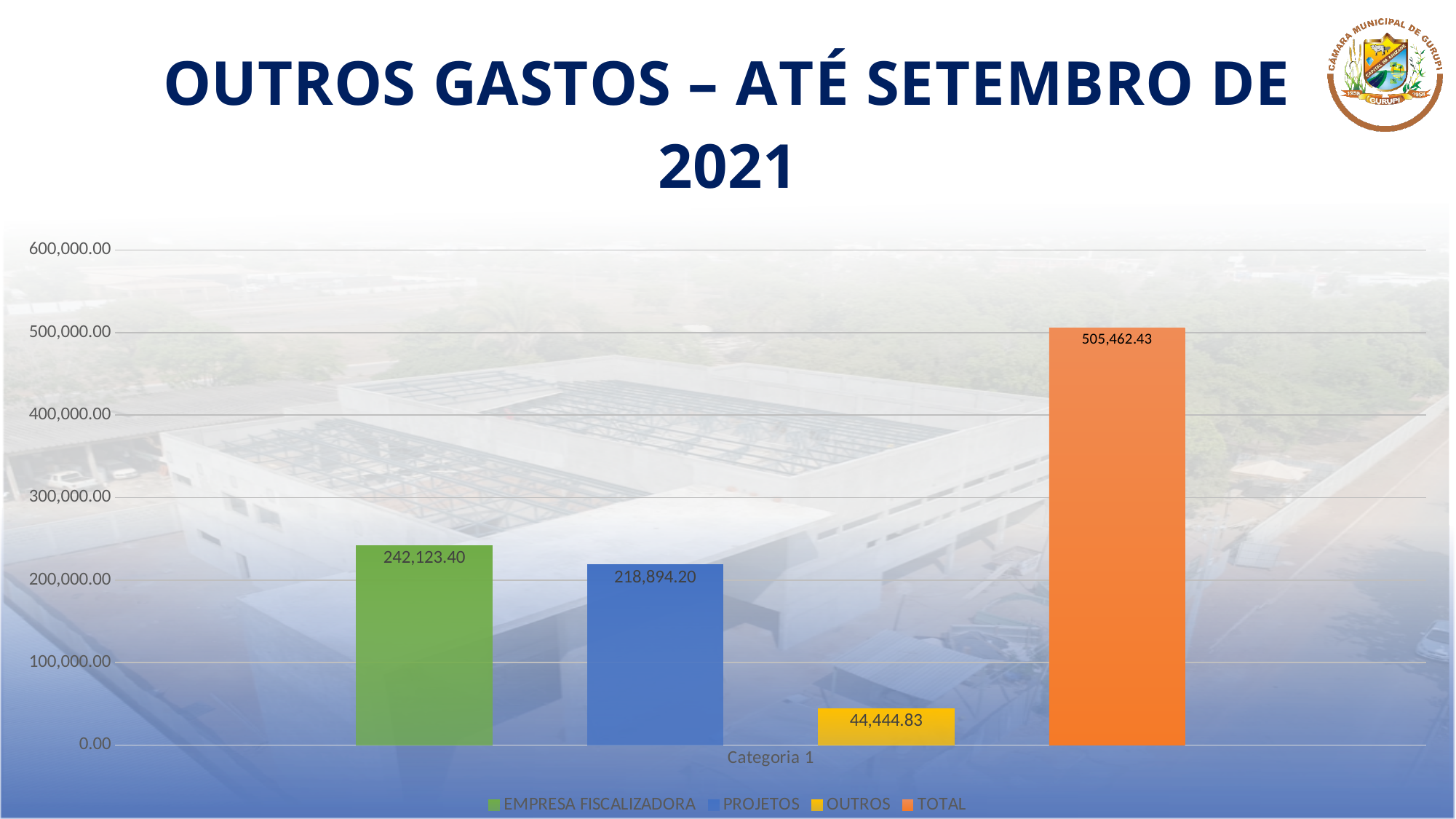
Is the value for TOTAL greater or less than 500,000.00? greater Which series has the highest value? TOTAL What kind of chart is shown on the slide? Bar chart Which is larger, EMPRESA FISCALIZADORA or PROJETOS? EMPRESA FISCALIZADORA What is the difference between EMPRESA FISCALIZADORA and PROJETOS? 23,229.20 What is the value for EMPRESA FISCALIZADORA? 242,123.40 What is the value for OUTROS? 44,444.83 What is the value for TOTAL? 505,462.43 What is the value for PROJETOS? 218,894.20 What is the difference between TOTAL and OUTROS? 461,017.60 How many series does the legend list? 4 Which series has the lowest value? OUTROS